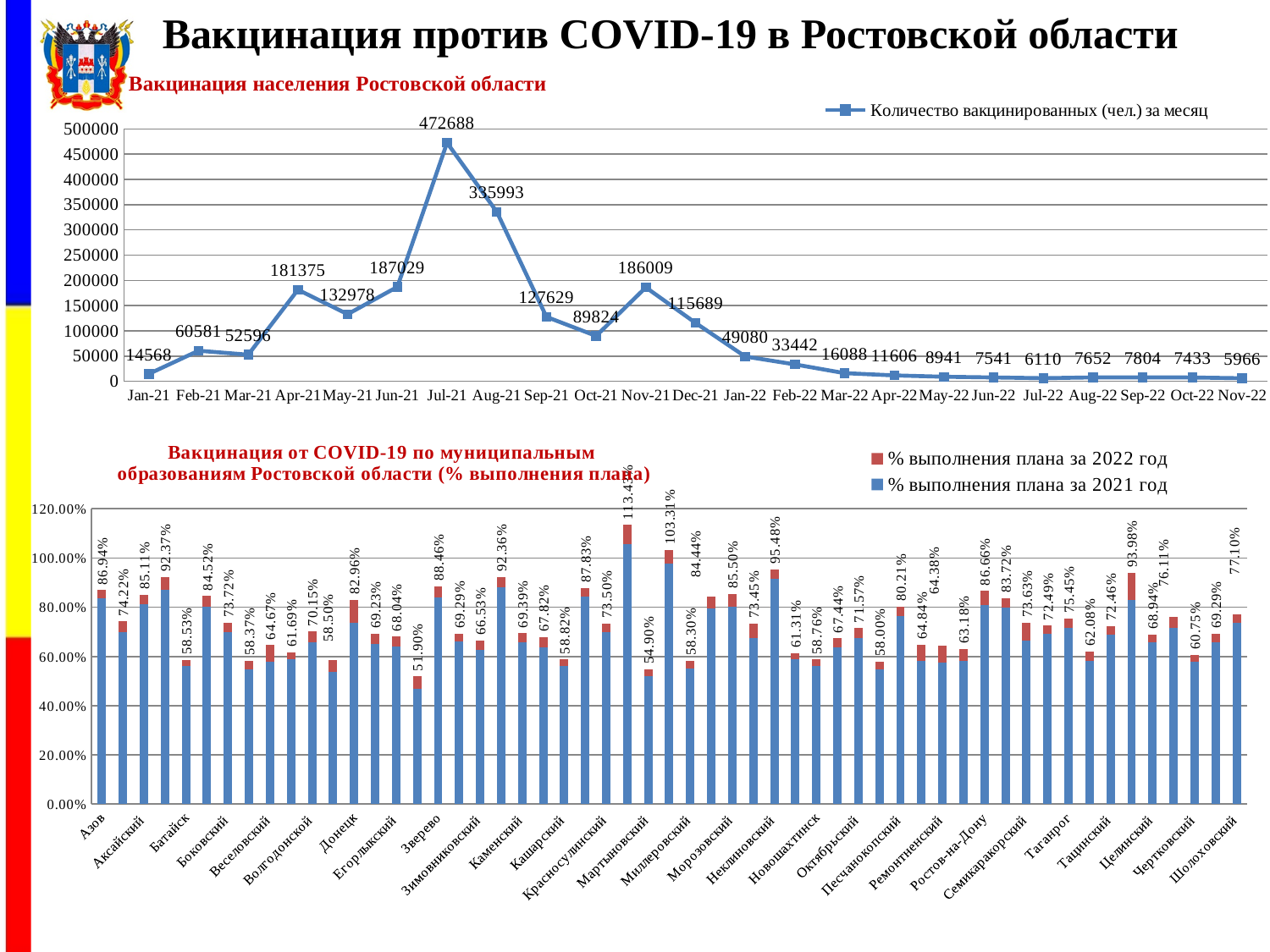
On the top chart 'Вакцинация населения Ростовской области', what is the value for Nov-22? 5966 What kind of chart is the bottom chart 'Вакцинация от COVID-19 по муниципальным образованиям Ростовской области'? bar chart How many series does the legend of the bottom chart 'Вакцинация от COVID-19 по муниципальным образованиям Ростовской области' list? 2 On the top chart 'Вакцинация населения Ростовской области', what is the number of vaccinated people for Jul-21? 472688 On the top chart 'Вакцинация населения Ростовской области', do the values rise or fall from Nov-21 to Jul-22? fall On the top chart 'Вакцинация населения Ростовской области', what is the difference between the values for Jul-21 and Aug-21? 136695 On the top chart 'Вакцинация населения Ростовской области', how many months are plotted? 23 On the top chart 'Вакцинация населения Ростовской области', which month has the highest number of vaccinated people? Jul-21 On the top chart 'Вакцинация населения Ростовской области', which month has the lowest number of vaccinated people? Nov-22 On the top chart 'Вакцинация населения Ростовской области', what is the value for Jan-21? 14568 On the bottom chart 'Вакцинация от COVID-19 по муниципальным образованиям Ростовской области', what is the highest percentage value shown? 113.43% On the top chart 'Вакцинация населения Ростовской области', which is larger, the value for Apr-21 or the value for Jun-21? Jun-21